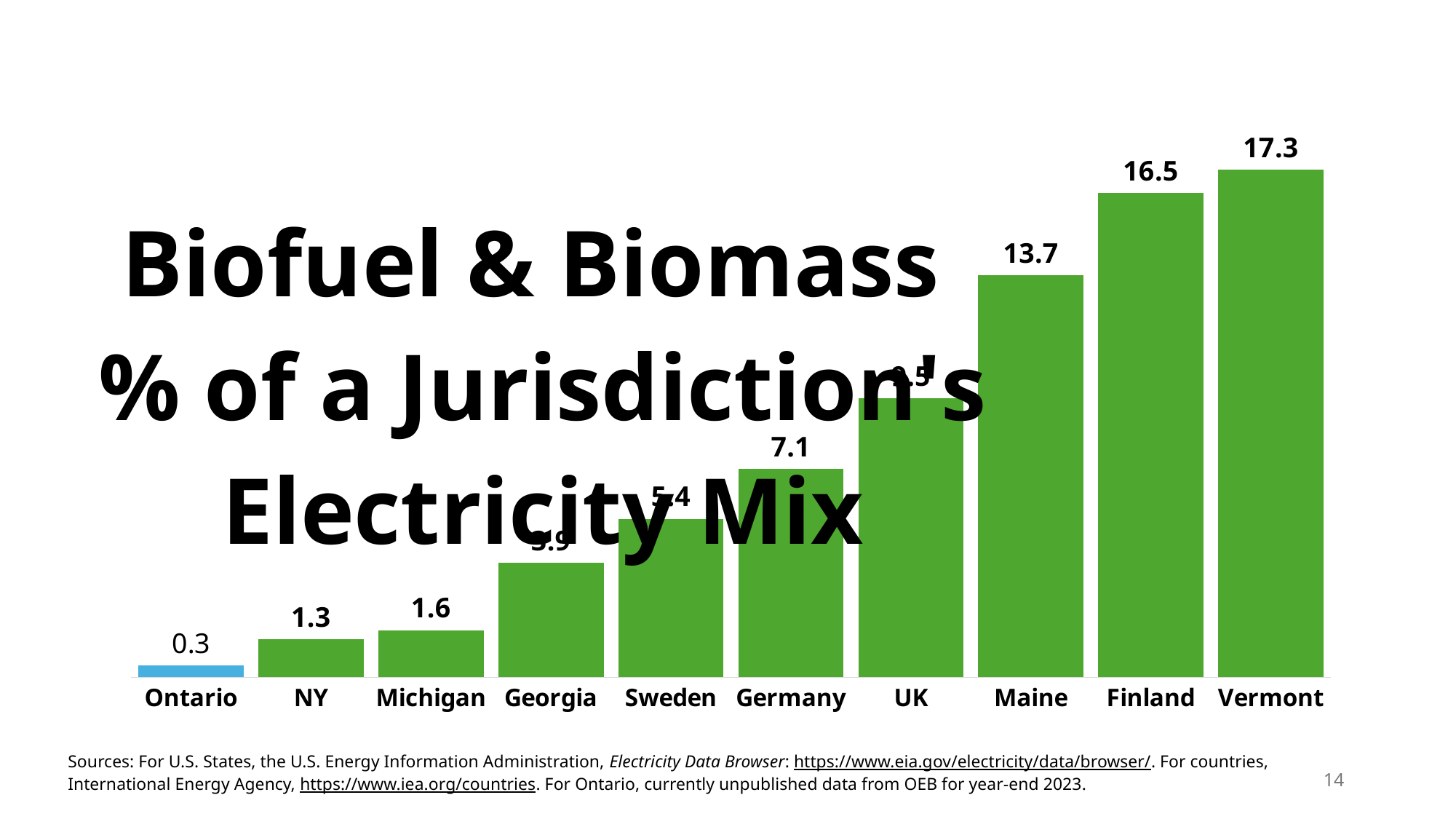
How many jurisdictions are shown in the chart? 10 What is the difference between the values for Vermont and Finland? 0.8 Which has a larger value, Finland or Maine? Finland Which jurisdiction has the lowest value? Ontario Do the values rise or fall from left to right across the chart? rise What is the value for Ontario? 0.3 What is the value for Vermont? 17.3 Which jurisdiction has the highest value? Vermont What is the difference between the values for Michigan and NY? 0.3 What is the value for Germany? 7.1 What type of chart is shown on the slide? bar chart What is the value for Maine? 13.7